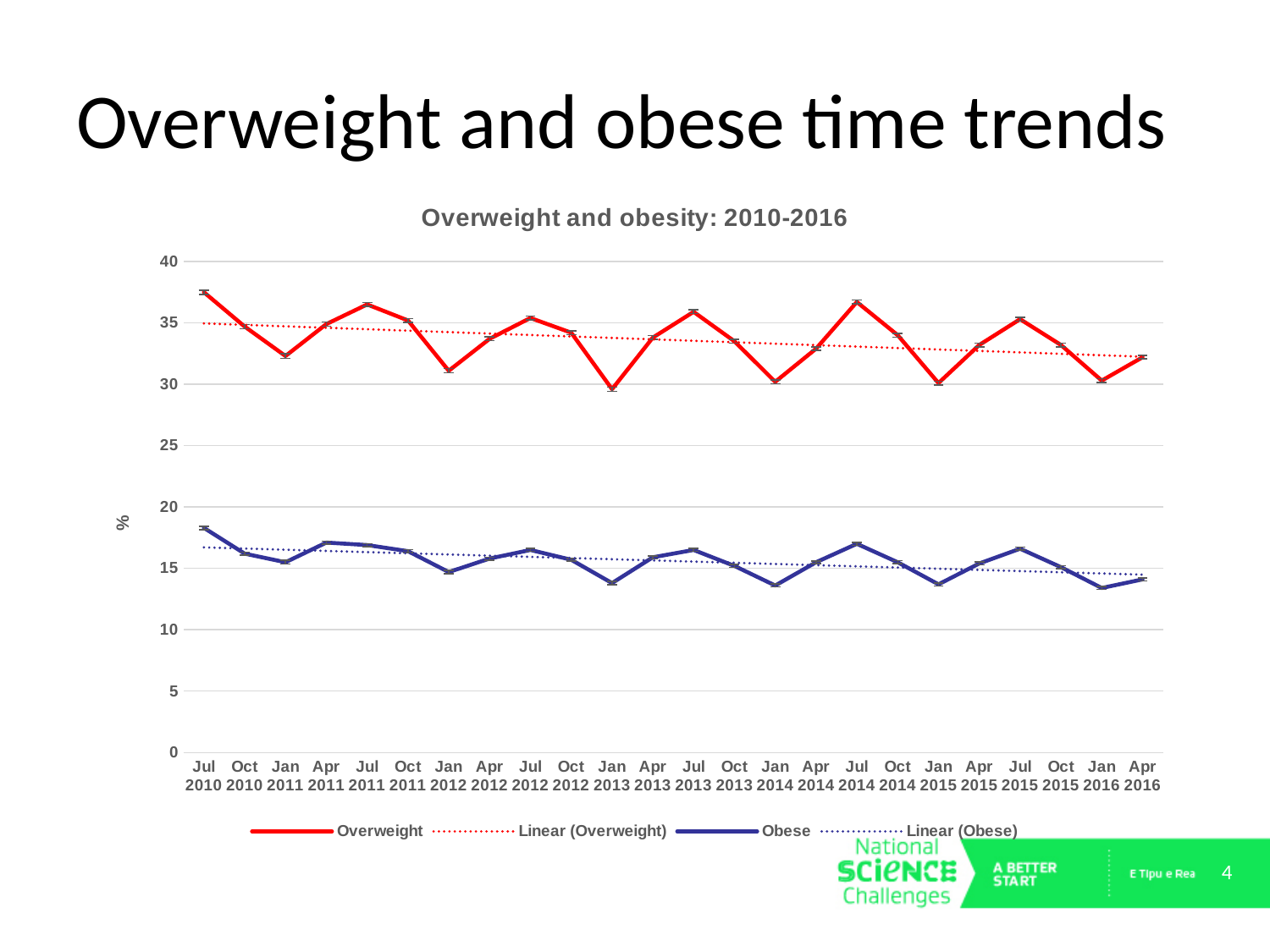
What is the title of the chart? Overweight and obesity: 2010-2016 Which series has the larger value in Apr 2016, Overweight or Obese? Overweight Does the Linear (Overweight) trendline rise or fall from 2010 to 2016? fall Is the Obese value for Jan 2016 greater or less than 15? less Is the Overweight value for Jan 2012 greater or less than 35? less At which time point is the Obese series highest? Jul 2010 How many entries does the chart legend list? 4 Is the Obese value for Jul 2010 greater or less than 15? greater How many time points are plotted along the x axis? 24 At which time point is the Overweight series highest? Jul 2010 What kind of chart is shown on the slide? line chart